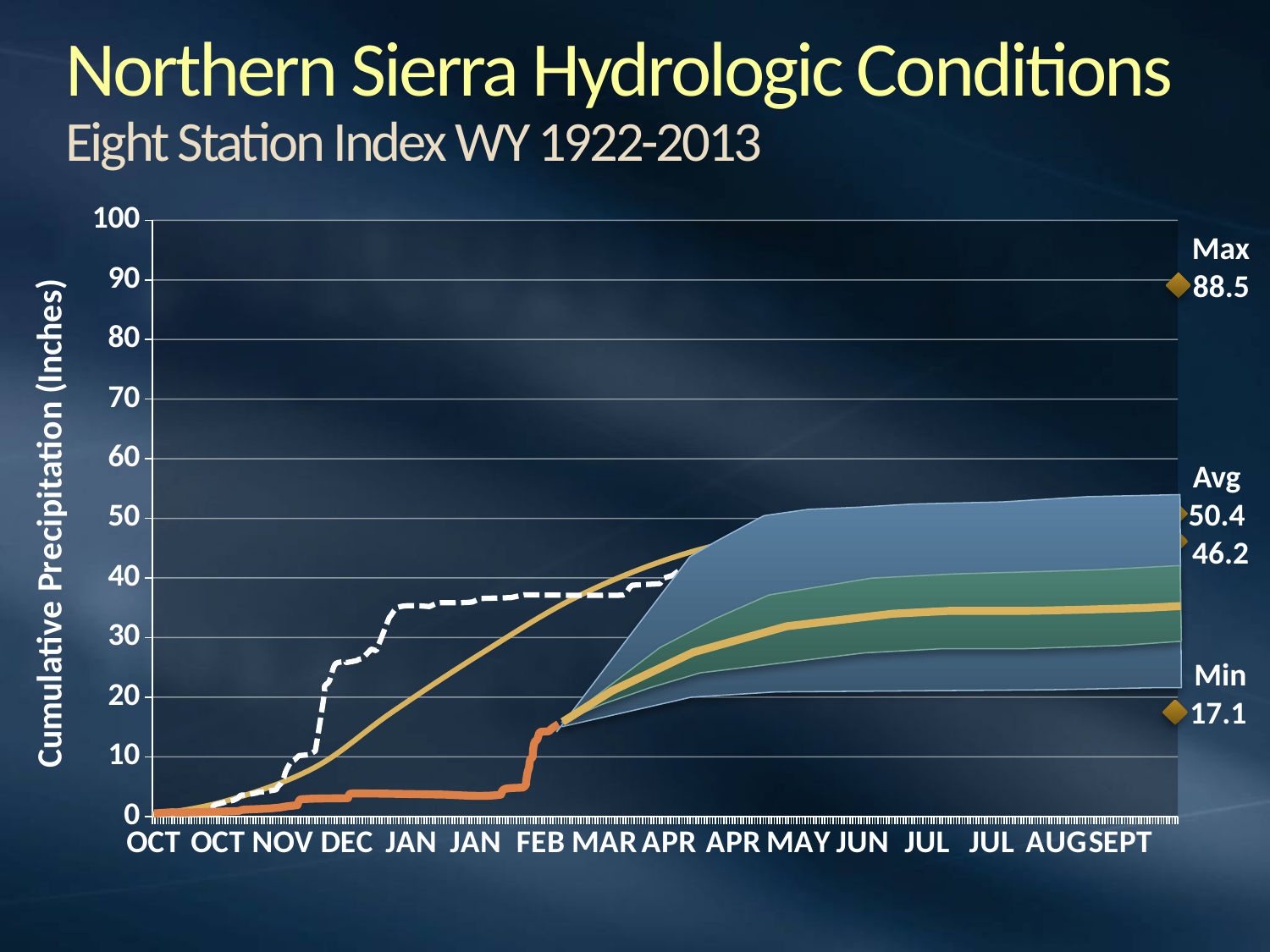
What is the label on the vertical axis of the chart? Cumulative Precipitation (Inches) What is the difference between the labelled Avg (50.4) and Min (17.1) values? 33.3 What is the Avg value labelled on the chart? 50.4 What kind of chart is shown on the slide? line chart Is the labelled Min value greater or less than 20? less Is the value of the solid orange line at the end of FEB greater or less than 20? less Do the plotted lines generally rise or fall from OCT to SEPT? rise What is the Max value labelled on the chart? 88.5 What is the Min value labelled on the chart? 17.1 What is the difference between the labelled Max (88.5) and Min (17.1) values? 71.4 Which labelled value is larger, Avg (50.4) or the 46.2 value? Avg (50.4) Is the labelled Max value greater or less than 80? greater